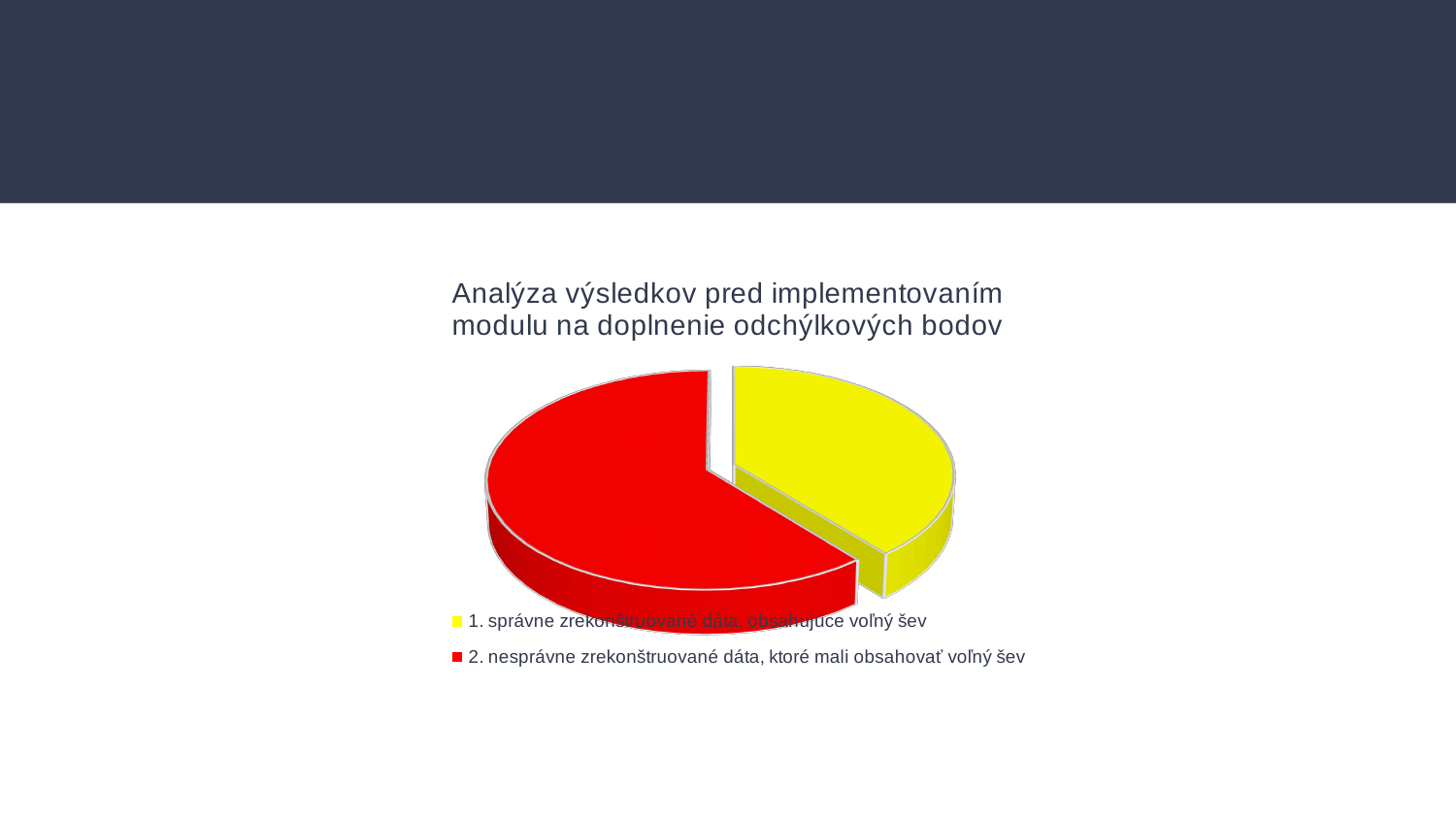
Which category has the smallest slice in the pie chart? 1. správne zrekonštruované dáta, obsahujúce voľný šev Which category has the largest slice in the pie chart? 2. nesprávne zrekonštruované dáta, ktoré mali obsahovať voľný šev What is the title of the pie chart? Analýza výsledkov pred implementovaním modulu na doplnenie odchýlkových bodov How many slices does the pie chart have? 2 What colour is the slice for "1. správne zrekonštruované dáta, obsahujúce voľný šev"? yellow What kind of chart is shown on the slide? pie chart How many entries does the legend of the pie chart list? 2 Which slice is larger: the one for correctly reconstructed data (1.) or the one for incorrectly reconstructed data (2.)? 2. nesprávne zrekonštruované dáta, ktoré mali obsahovať voľný šev